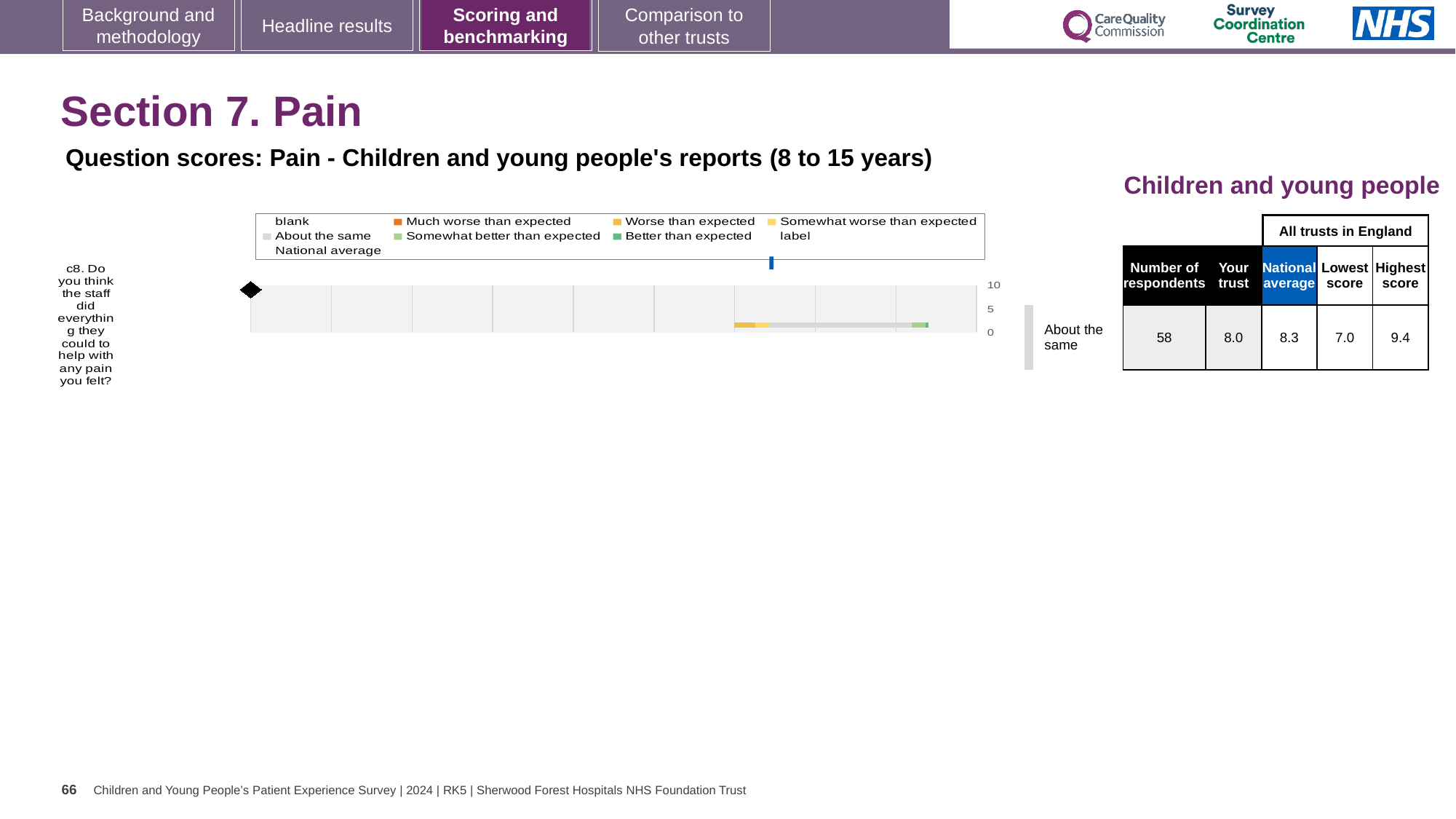
What kind of chart is shown on the slide? bar chart What is the difference between the highest score and the lowest score for question c8? 2.4 What is the national average score for question c8 shown in the table? 8.3 What is the lowest score among all trusts in England for question c8? 7.0 What is the 'Your trust' score for question c8 shown in the table? 8.0 How many respondents answered question c8? 58 What is the highest tick value shown on the chart's axis? 10 How many survey questions are plotted in the chart? 1 What benchmark category is given for question c8? About the same Which survey question is plotted in the chart? c8. Do you think the staff did everything they could to help with any pain you felt? What is the highest score among all trusts in England for question c8? 9.4 Which is larger for question c8: the 'Your trust' score or the national average? national average